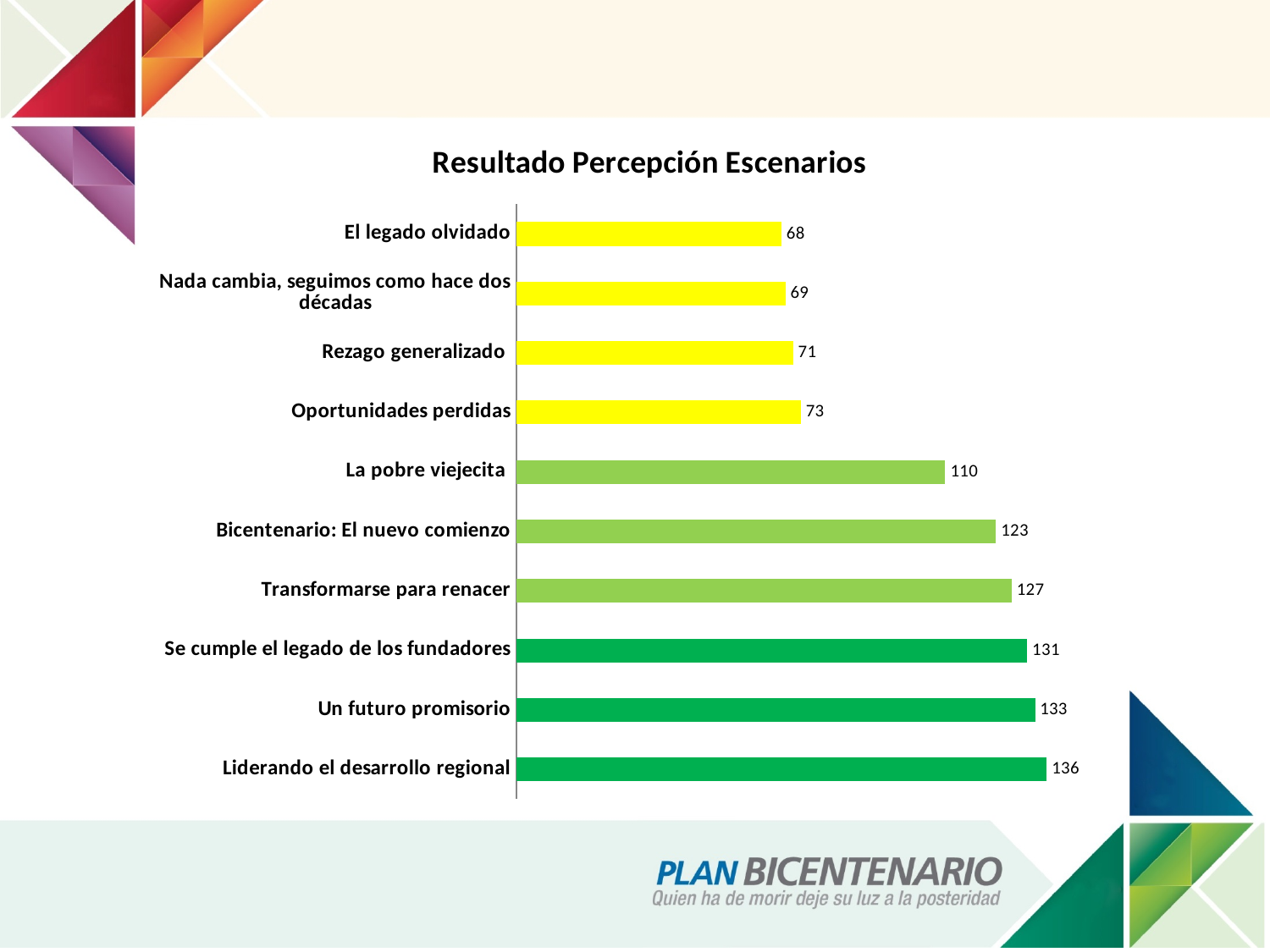
What is the value for "Transformarse para renacer"? 127 What is the difference between the values for "Liderando el desarrollo regional" and "El legado olvidado"? 68 What is the value for "La pobre viejecita"? 110 Which category has the lowest value? El legado olvidado What is the difference between the values for "Un futuro promisorio" and "Se cumple el legado de los fundadores"? 2 How many categories are shown in the chart? 10 What kind of chart is shown on the slide? Bar chart What is the title of the chart? Resultado Percepción Escenarios What is the value for "Rezago generalizado"? 71 What colour are the bars for the four lowest-valued categories? Yellow Which category has the highest value? Liderando el desarrollo regional Which has a larger value, "Bicentenario: El nuevo comienzo" or "Oportunidades perdidas"? Bicentenario: El nuevo comienzo